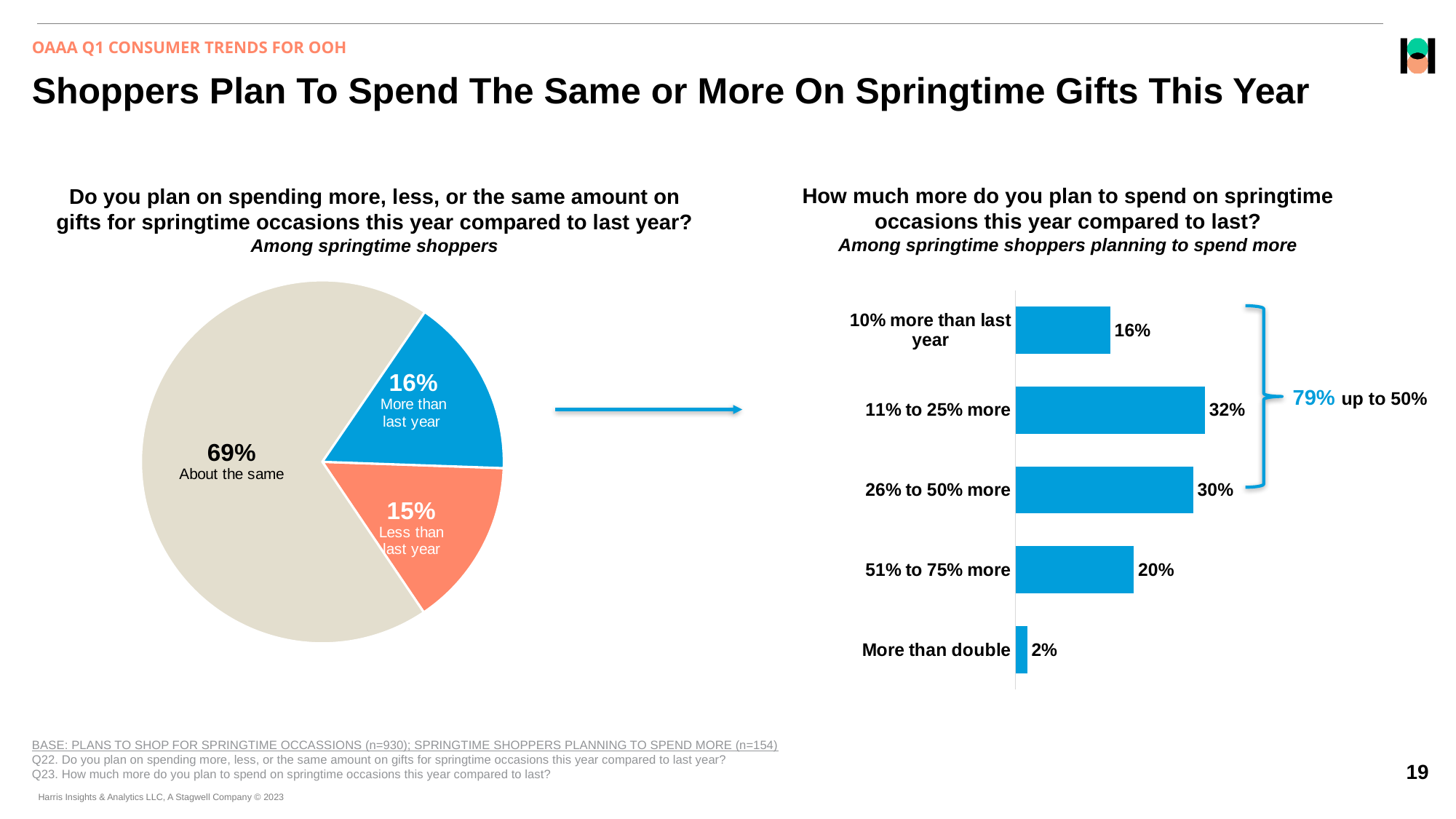
In the pie chart on the left, what percentage of springtime shoppers plan to spend less than last year? 15% In the bar chart on the right, what percentage of shoppers planning to spend more plan to spend 11% to 25% more? 32% What kind of chart is shown on the left side of the slide? Pie chart What kind of chart is shown on the right side of the slide? Bar chart In the bar chart on the right, which category has the lowest value? More than double In the pie chart on the left, what share of springtime shoppers plan to spend about the same as last year? 69% In the pie chart on the left, which response has the largest slice? About the same In the bar chart on the right, what is the difference between the values for '51% to 75% more' and '10% more than last year'? 4% In the bar chart on the right, which category has the highest value? 11% to 25% more In the bar chart on the right, how many categories are shown? 5 In the bar chart on the right, what is the value for 'More than double'? 2% In the pie chart on the left, how many slices are there? 3